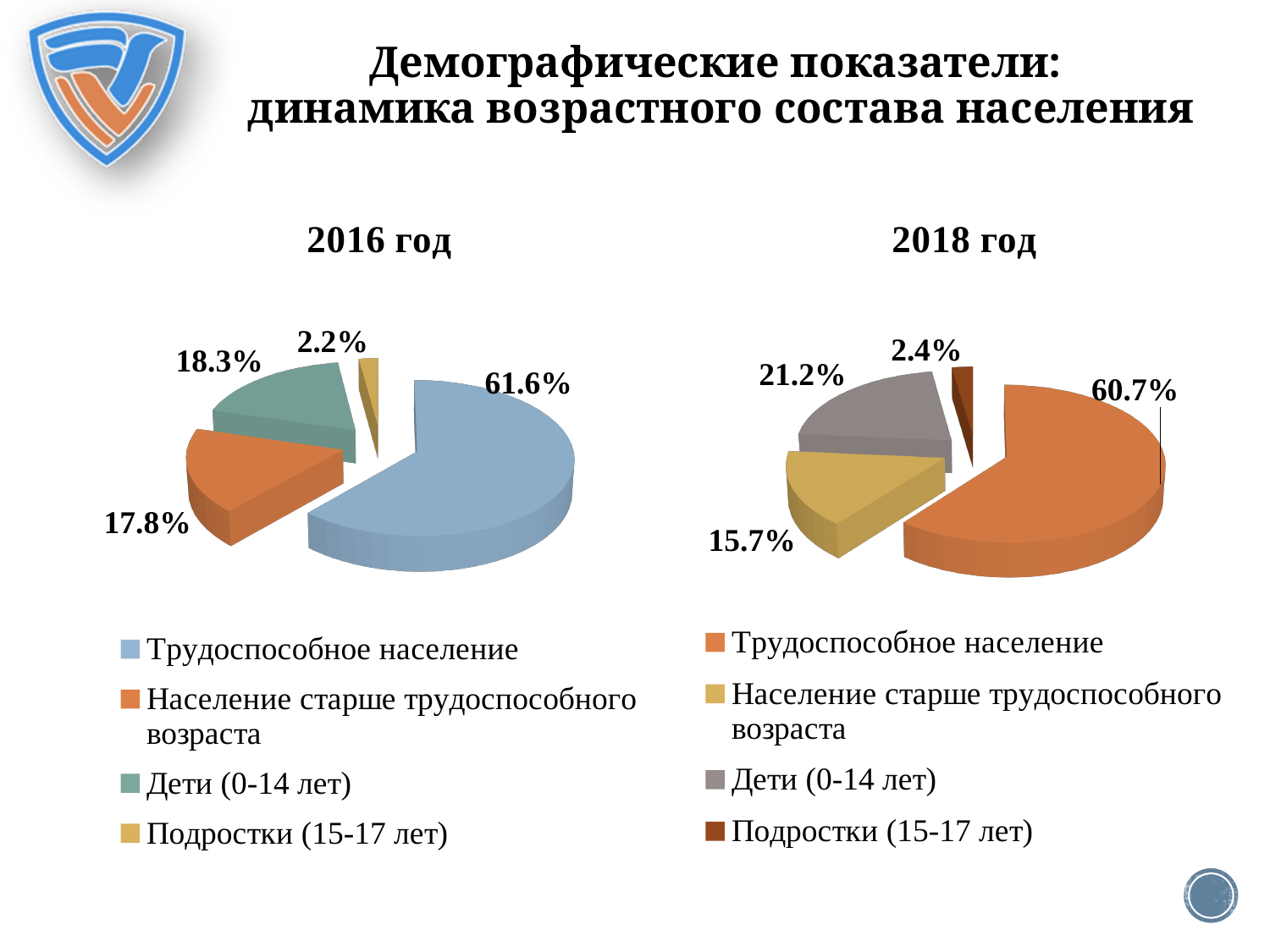
What type of chart is used for "2018 год"? Pie chart In the "2018 год" chart, which category has the largest slice? Трудоспособное население In the "2018 год" chart, what colour is the slice for Подростки (15-17 лет)? Dark red Which is larger: the share of Дети (0-14 лет) in the "2016 год" chart or in the "2018 год" chart? 2018 год In the "2018 год" chart, what is the difference between the shares of Дети (0-14 лет) and Население старше трудоспособного возраста? 5.5% How many categories does the "2016 год" chart show? 4 In the "2018 год" chart, what is the value for Население старше трудоспособного возраста? 15.7% In the "2016 год" chart, what is the share for Трудоспособное население? 61.6% In the "2016 год" chart, what is the value for Подростки (15-17 лет)? 2.2% In the "2016 год" chart, which category has the smallest slice? Подростки (15-17 лет) In the "2018 год" chart, what is the share for Дети (0-14 лет)? 21.2% In the "2016 год" chart, what is the difference between the shares of Дети (0-14 лет) and Население старше трудоспособного возраста? 0.5%